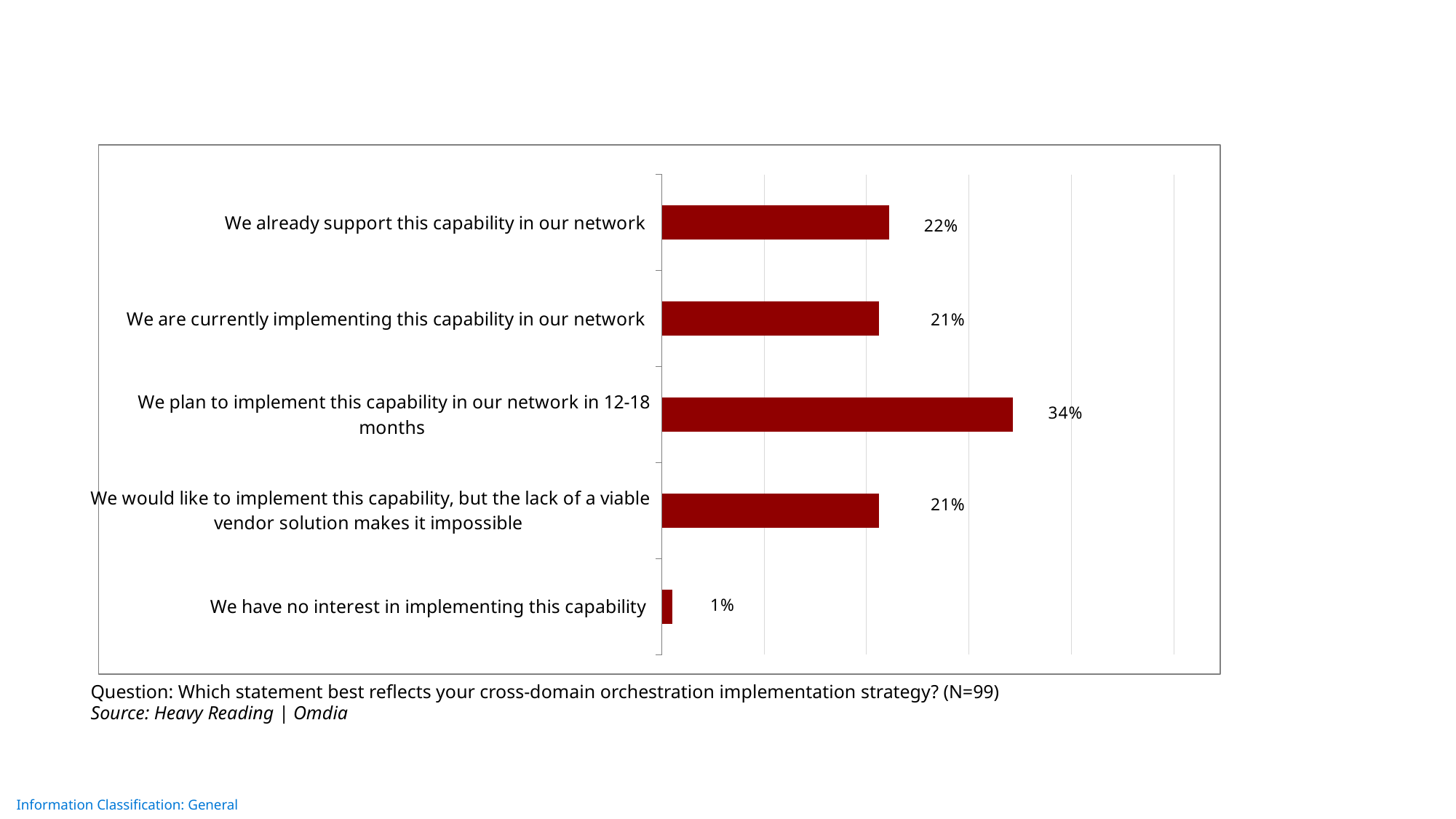
Which statement received the highest share of responses? We plan to implement this capability in our network in 12-18 months What percentage of respondents said they already support this capability in their network? 22% Which statement received the lowest share of responses? We have no interest in implementing this capability What percentage of respondents have no interest in implementing this capability? 1% How many statements (categories) are shown in the chart? 5 What type of chart is shown on the slide? Bar chart What is the difference in percentage points between 'We plan to implement this capability in our network in 12-18 months' and 'We already support this capability in our network'? 12 percentage points What percentage of respondents are currently implementing this capability in their network? 21% Which is larger: the share for 'We already support this capability in our network' or the share for 'We have no interest in implementing this capability'? We already support this capability in our network What is the source cited for the chart? Heavy Reading | Omdia What is the sample size (N) given in the question text below the chart? 99 What percentage of respondents plan to implement this capability in their network in 12-18 months? 34%